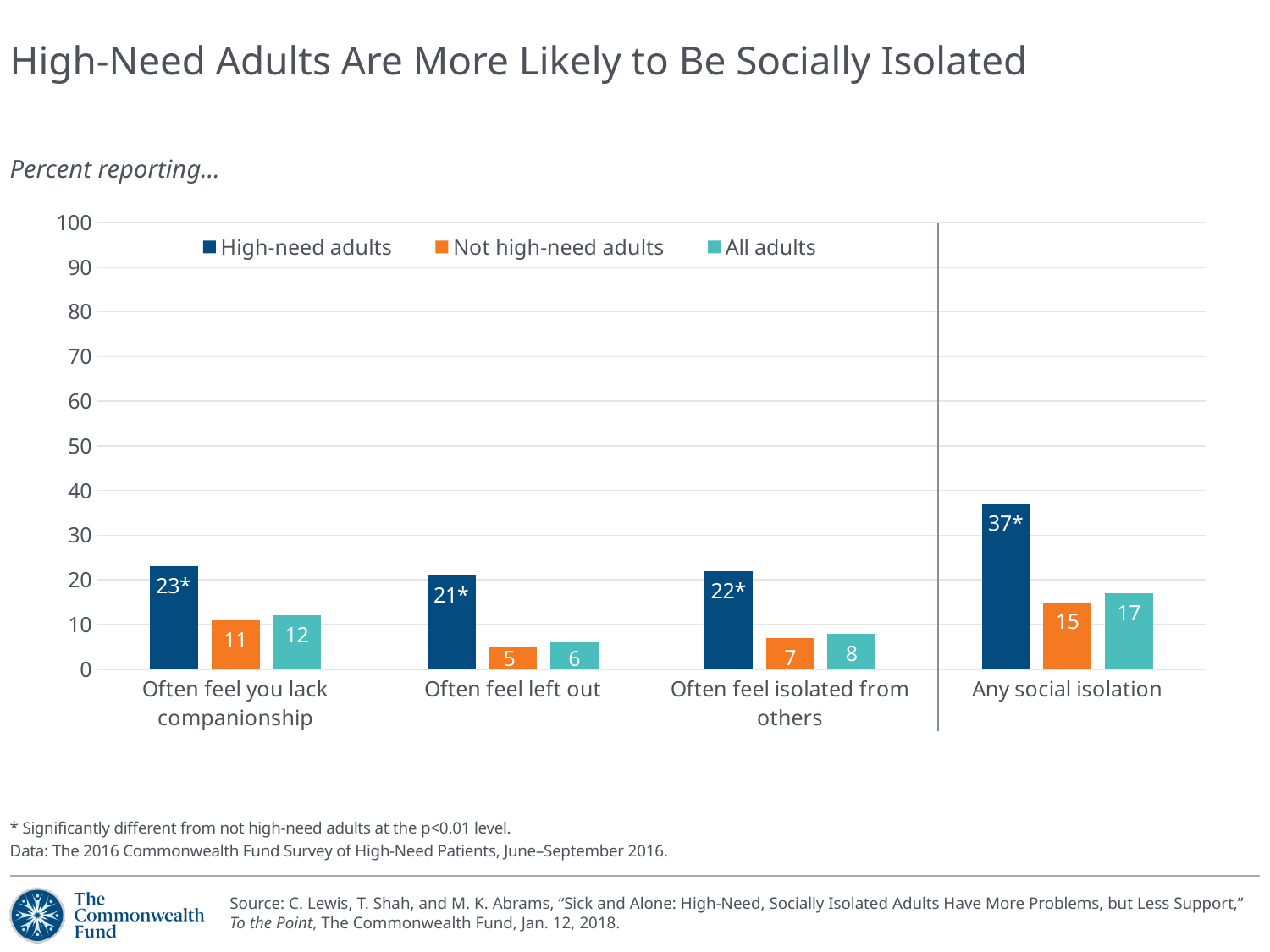
What does the asterisk on the data labels indicate? Significantly different from not high-need adults at the p<0.01 level Which category has the lowest value for not high-need adults? Often feel left out Which category has the highest value for high-need adults? Any social isolation What kind of chart is shown on the slide? Bar chart How many series does the legend list? 3 Which is larger for 'Any social isolation': not high-need adults or all adults? All adults Is the value for high-need adults in 'Often feel isolated from others' greater or less than 30? less How many categories are shown on the x axis? 4 What is the difference between high-need adults and not high-need adults for 'Often feel you lack companionship'? 12 What percent of all adults report often feeling isolated from others? 8 What percent of high-need adults report any social isolation? 37* What percent of not high-need adults report often feeling left out? 5